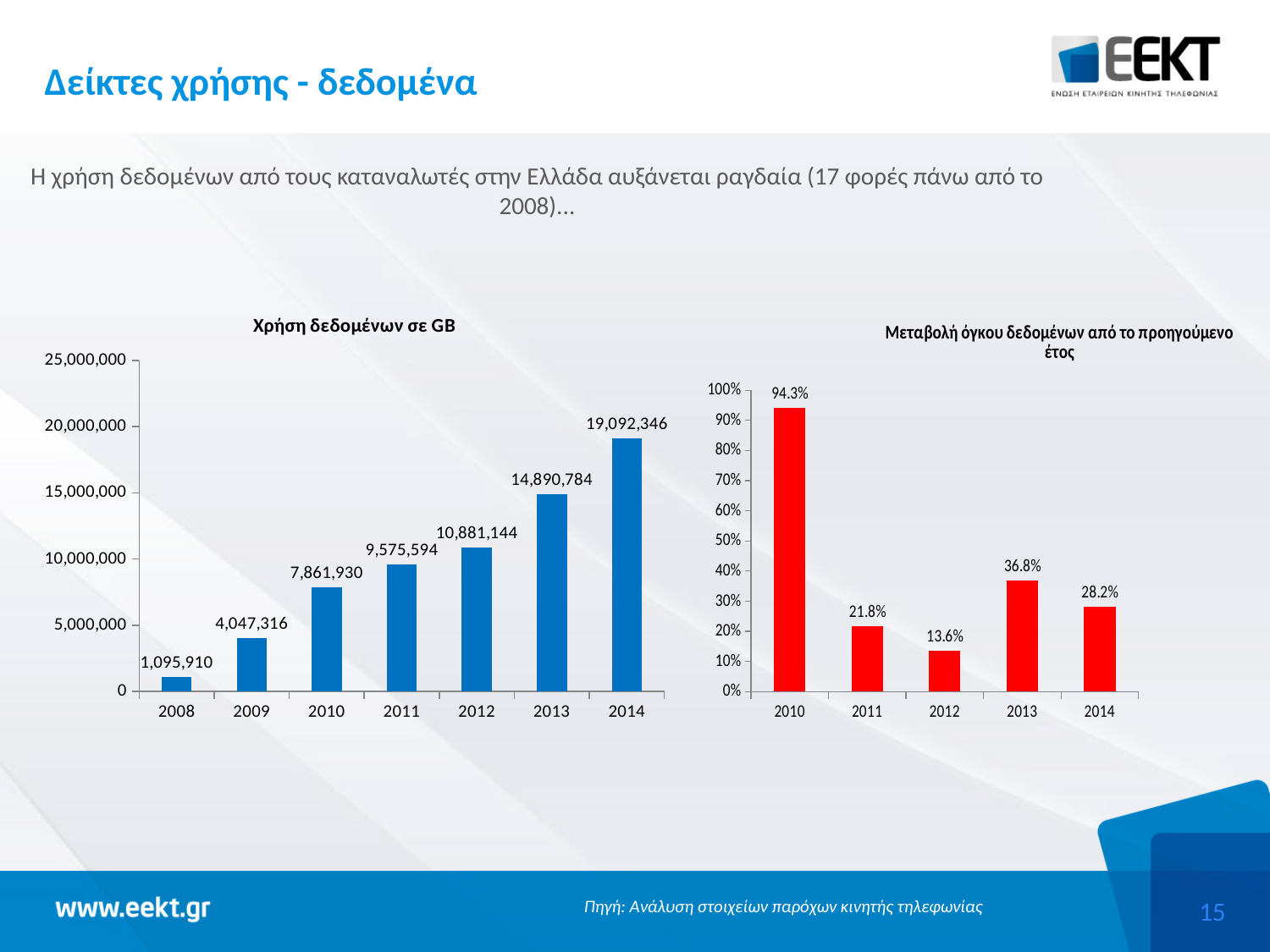
In the 'Χρήση δεδομένων σε GB' chart, what is the value for 2012? 10,881,144 In the 'Χρήση δεδομένων σε GB' chart, what is the value for 2008? 1,095,910 In the 'Χρήση δεδομένων σε GB' chart, do the values rise or fall from 2008 to 2014? rise In the 'Μεταβολή όγκου δεδομένων από το προηγούμενο έτος' chart, what is the value for 2013? 36.8% In the 'Χρήση δεδομένων σε GB' chart, what is the difference between the 2014 and 2013 values? 4,201,562 In the 'Χρήση δεδομένων σε GB' chart, which year has the lowest value? 2008 In the 'Μεταβολή όγκου δεδομένων από το προηγούμενο έτος' chart, what is the value for 2010? 94.3% In the 'Μεταβολή όγκου δεδομένων από το προηγούμενο έτος' chart, which year has the lowest value? 2012 In the 'Χρήση δεδομένων σε GB' chart, how many years are shown on the x axis? 7 In the 'Μεταβολή όγκου δεδομένων από το προηγούμενο έτος' chart, which is larger, the value for 2011 or the value for 2014? 2014 What kind of chart is the 'Μεταβολή όγκου δεδομένων από το προηγούμενο έτος' chart? bar chart In the 'Χρήση δεδομένων σε GB' chart, which year has the highest value? 2014